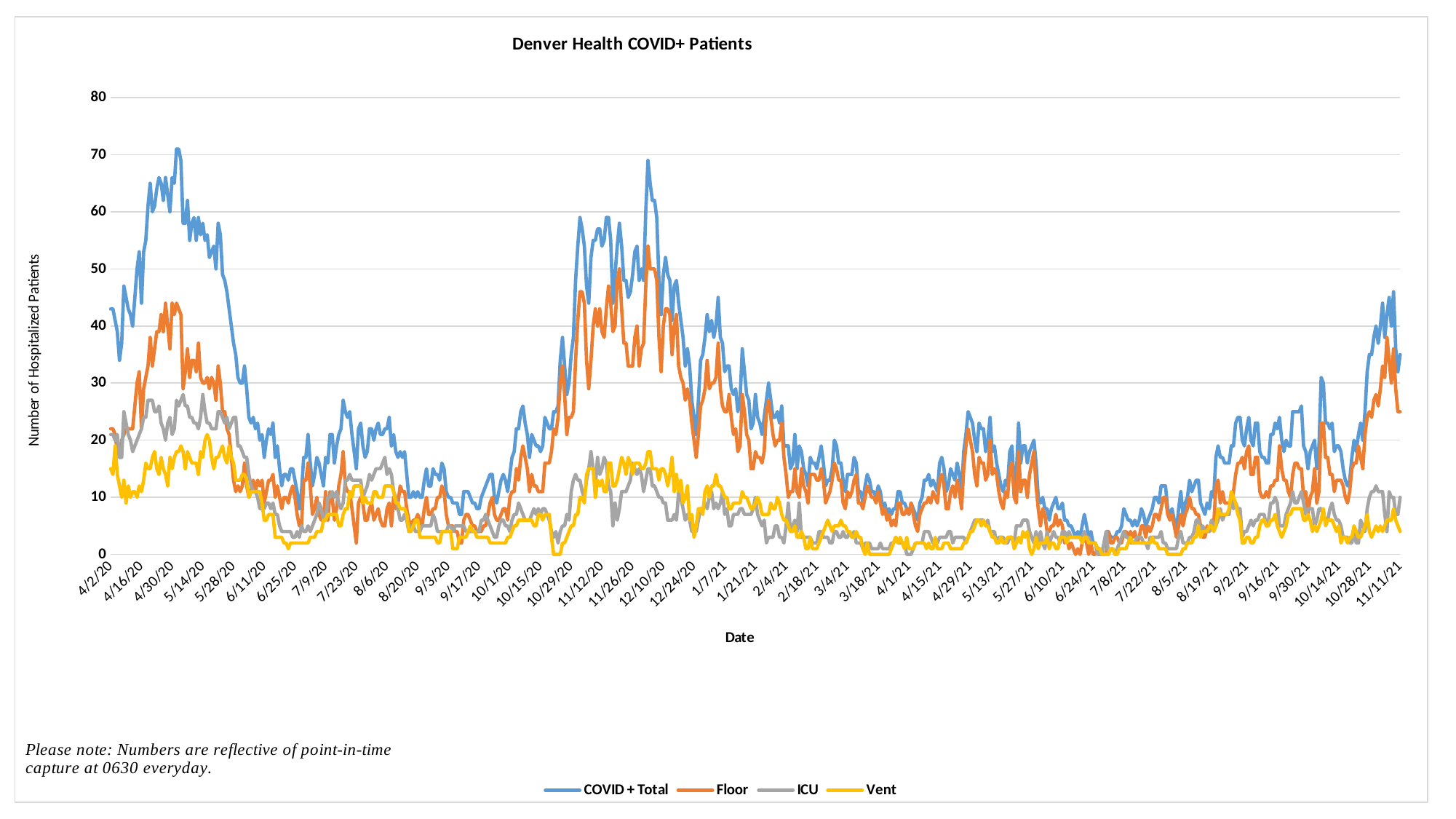
How many series does the legend list? 4 What is the title of the chart? Denver Health COVID+ Patients Is the highest value of the Vent series greater or less than 30? less Is the COVID + Total value around 6/24/21 greater or less than 10? less Is the peak value of COVID + Total around 4/30/20 greater or less than 60? greater Which series reaches the highest value anywhere on the chart? COVID + Total Between 4/30/20 and 6/25/20, does the COVID + Total series generally rise or fall? fall Which series has larger values around 11/26/20, Floor or ICU? Floor Which series has the lowest peak value on the chart? Vent What kind of chart is shown on the slide? line chart What is the label on the vertical axis? Number of Hospitalized Patients